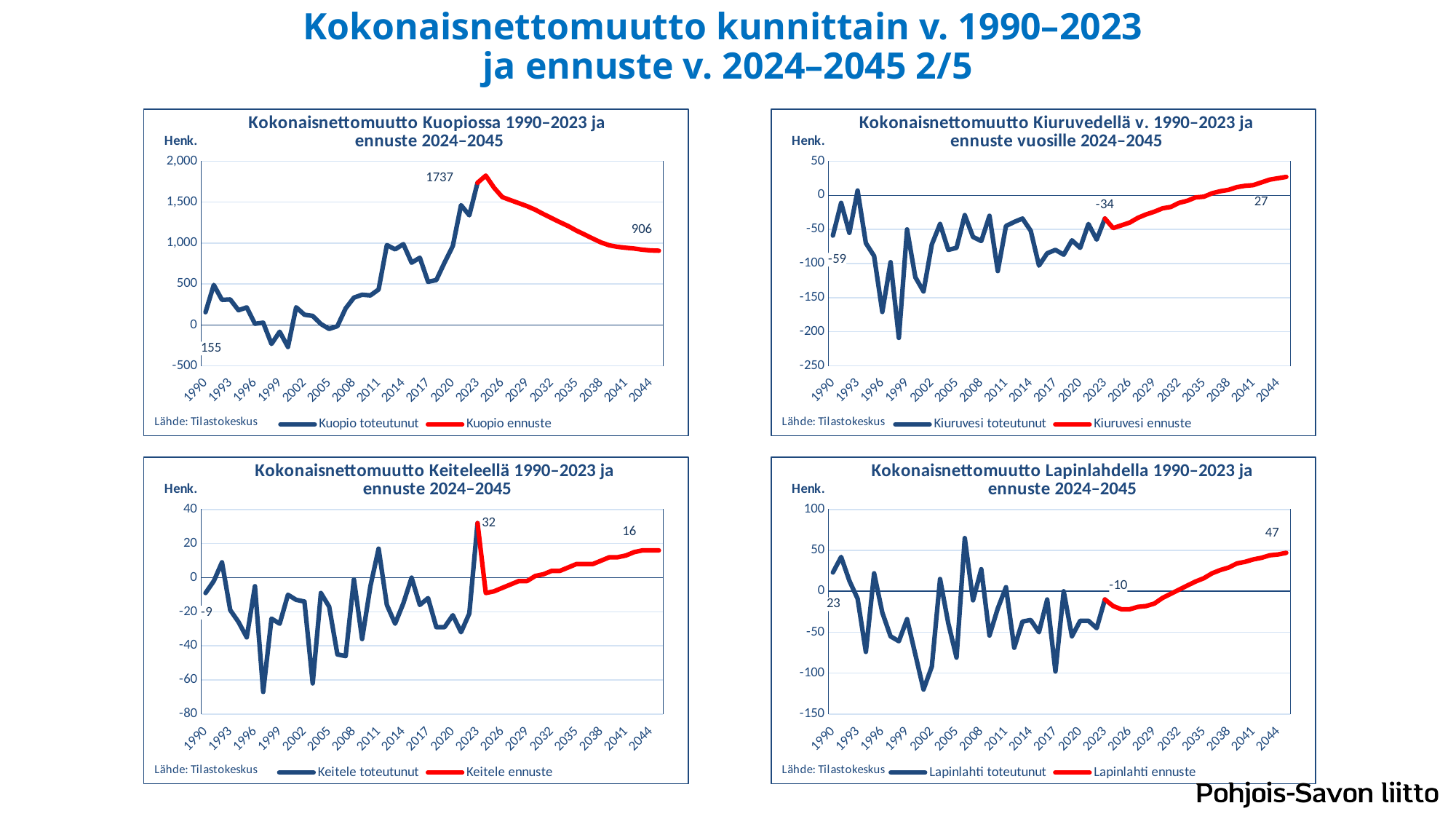
In the Kuopio chart (top left), what is the labelled value for 2023? 1737 In the Kuopio chart (top left), does the forecast line rise or fall from 2024 to 2045? fall In the Kiuruvesi chart (top right), does the forecast line rise or fall from 2024 to 2045? rise How many series does the legend of the Lapinlahti chart (bottom right) list? 2 In the Kuopio chart (top left), what is the difference between the labelled 2023 value and the labelled 2045 forecast value? 831 In the Keitele chart (bottom left), what is the labelled value for 2023? 32 In the Kiuruvesi chart (top right), what is the labelled value for 2023? -34 In the Keitele chart (bottom left), what is the difference between the labelled 2023 value and the labelled 2045 forecast value? 16 In the Kiuruvesi chart (top right), what is the labelled value for 1990? -59 In the Lapinlahti chart (bottom right), what is the labelled forecast value for 2045? 47 In the Kuopio chart (top left), what is the labelled forecast value for 2045? 906 In the Lapinlahti chart (bottom right), is the value for 2001 greater or less than -100? less